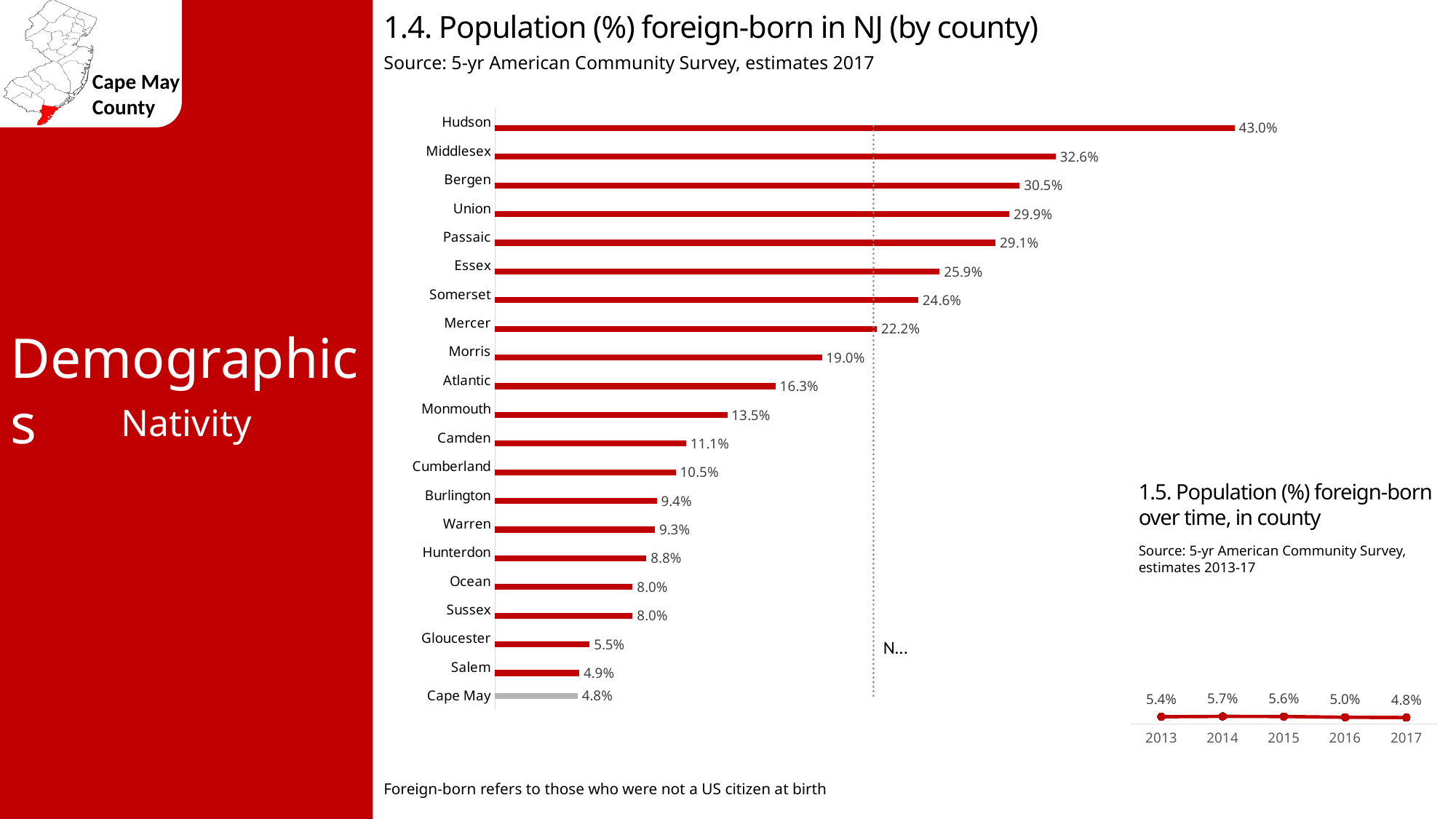
In the chart '1.5. Population (%) foreign-born over time, in county', what is the difference between 2013 and 2017? 0.6% In the chart '1.4. Population (%) foreign-born in NJ (by county)', what is the difference between Middlesex and Bergen? 2.1% In the chart '1.5. Population (%) foreign-born over time, in county', what is the value for 2014? 5.7% In the chart '1.5. Population (%) foreign-born over time, in county', which year has the lowest value? 2017 In the chart '1.4. Population (%) foreign-born in NJ (by county)', which county has the lowest value? Cape May In the chart '1.4. Population (%) foreign-born in NJ (by county)', what is the value for Hudson? 43.0% In the chart '1.4. Population (%) foreign-born in NJ (by county)', which county has the highest value? Hudson In the chart '1.4. Population (%) foreign-born in NJ (by county)', what is the value for Cape May? 4.8% What kind of chart is '1.4. Population (%) foreign-born in NJ (by county)'? Bar chart In the chart '1.4. Population (%) foreign-born in NJ (by county)', which is larger, Morris or Atlantic? Morris In the chart '1.4. Population (%) foreign-born in NJ (by county)', how many counties are shown? 21 What kind of chart is '1.5. Population (%) foreign-born over time, in county'? Line chart